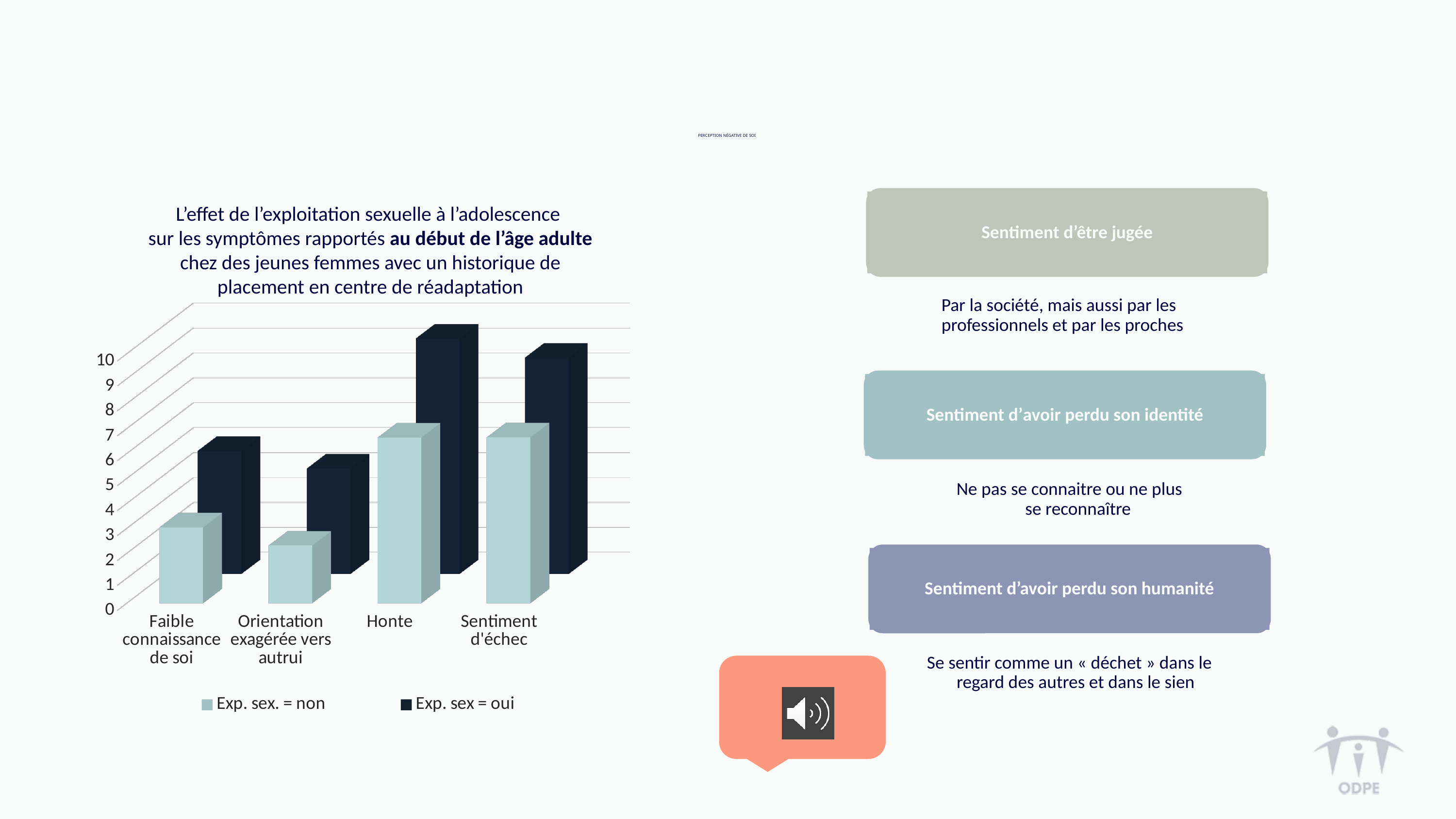
What kind of chart is shown on the slide? bar chart How many series does the chart's legend list? 2 Is the Exp. sex = oui value for Orientation exagérée vers autrui greater or less than 8? less Which category has the lowest value for the Exp. sex = oui series? Orientation exagérée vers autrui For the Exp. sex = oui series, which is larger, Honte or Orientation exagérée vers autrui? Honte Which category has the highest value for the Exp. sex = oui series? Honte Is the Exp. sex = oui value for Honte greater or less than 8? greater Is the Exp. sex. = non value for Faible connaissance de soi greater or less than 5? less What are the two series named in the chart's legend? Exp. sex. = non and Exp. sex = oui For Faible connaissance de soi, which series has the larger value, Exp. sex. = non or Exp. sex = oui? Exp. sex = oui How many categories are shown on the x axis of the chart? 4